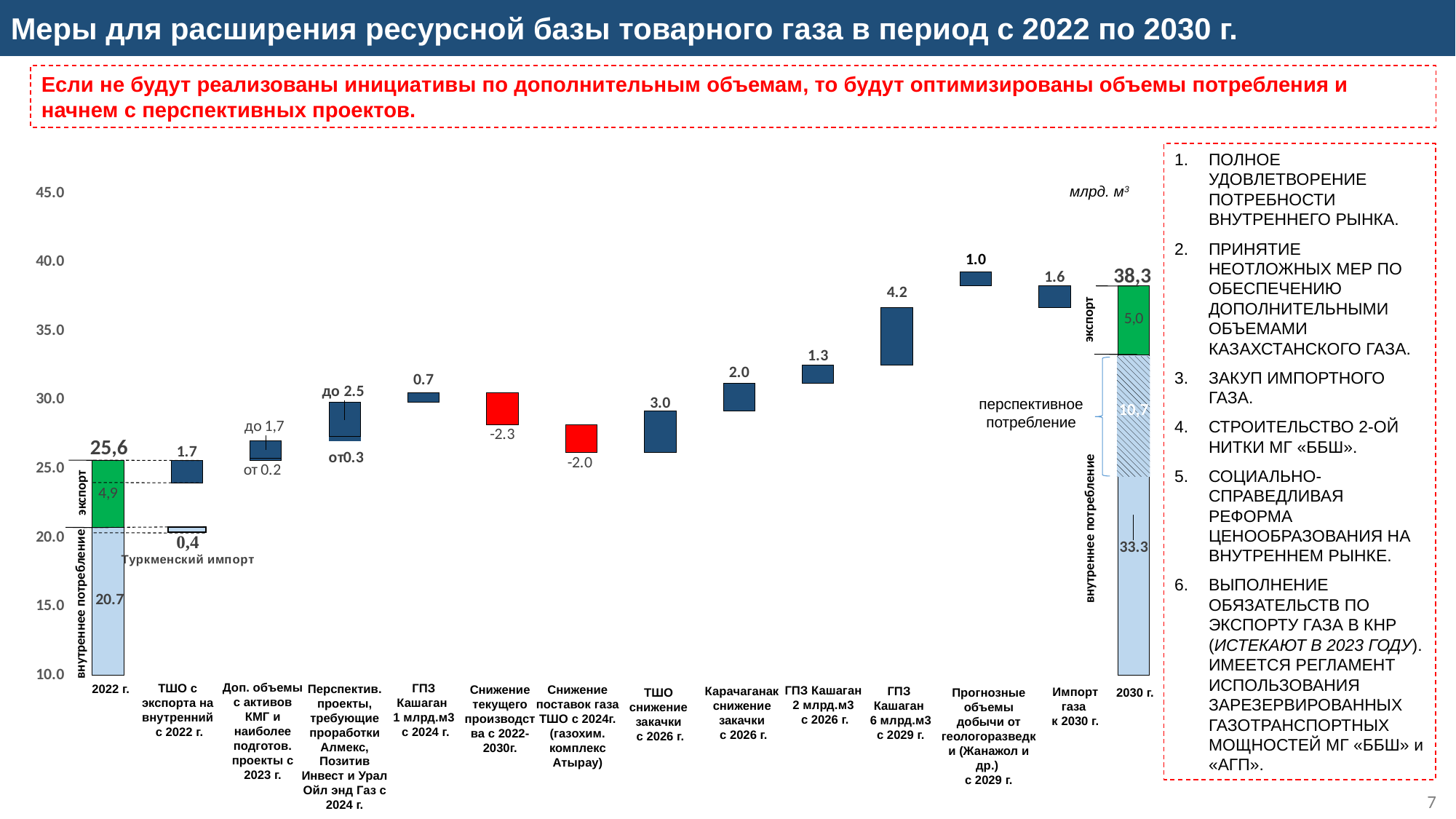
By how much does the 2030 г. total (38,3) exceed the 2022 г. total (25,6)? 12,7 Excluding the 2022 г. and 2030 г. total bars, which step adds the largest volume? ГПЗ Кашаган 6 млрд.м3 с 2029 г. What total value is labelled on the 2030 г. bar? 38,3 What value is shown for "Импорт газа к 2030 г."? 1.6 What is the внутреннее потребление value shown in the 2030 г. bar? 33.3 What unit is indicated for the values in the chart? млрд. м³ What is the export (экспорт) value shown in the 2022 г. bar? 4,9 Which is larger: "ТШО снижение закачки с 2026 г." or "Карачаганак снижение закачки с 2026 г."? ТШО снижение закачки с 2026 г. What value is labelled for "Туркменский импорт"? 0,4 Which step has the lowest (most negative) value? Снижение текущего производства с 2022-2030г. What value is shown for the bar "ГПЗ Кашаган 6 млрд.м3 с 2029 г."? 4.2 What value is shown for "Снижение текущего производства с 2022-2030г."? -2.3